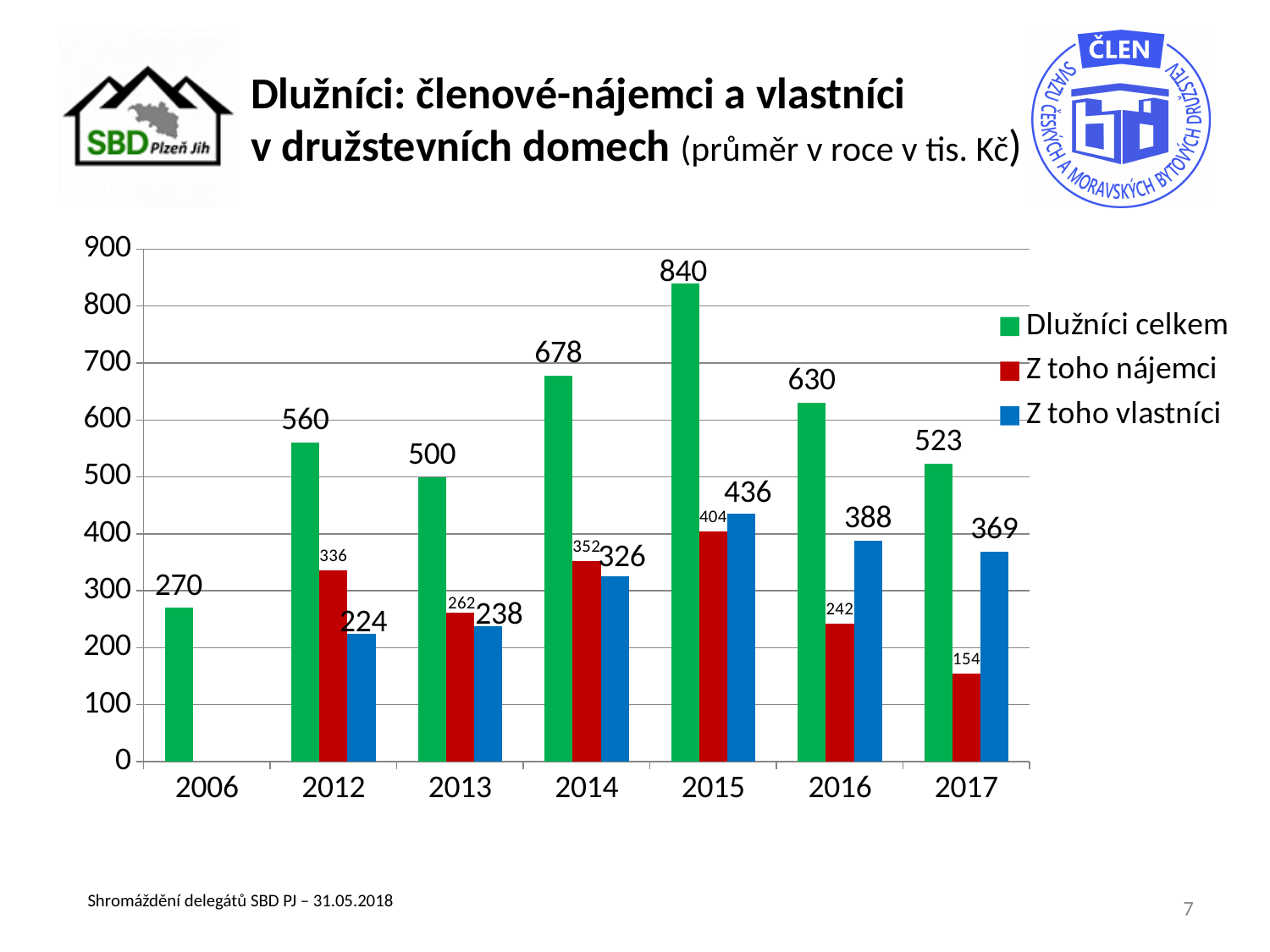
What is the value of Dlužníci celkem for 2015? 840 What kind of chart is shown on the slide? Bar chart Which year has the highest value for Dlužníci celkem? 2015 Does Dlužníci celkem rise or fall from 2015 to 2017? Fall What colour are the Z toho vlastníci bars? Blue What is the value of Z toho vlastníci for 2017? 369 How many series does the legend list? 3 Which year has the lowest value for Z toho nájemci? 2017 Which is larger in 2014: Z toho nájemci or Z toho vlastníci? Z toho nájemci What is the difference between Dlužníci celkem in 2015 and in 2016? 210 What is the value of Z toho nájemci for 2012? 336 How many years are shown on the x axis? 7